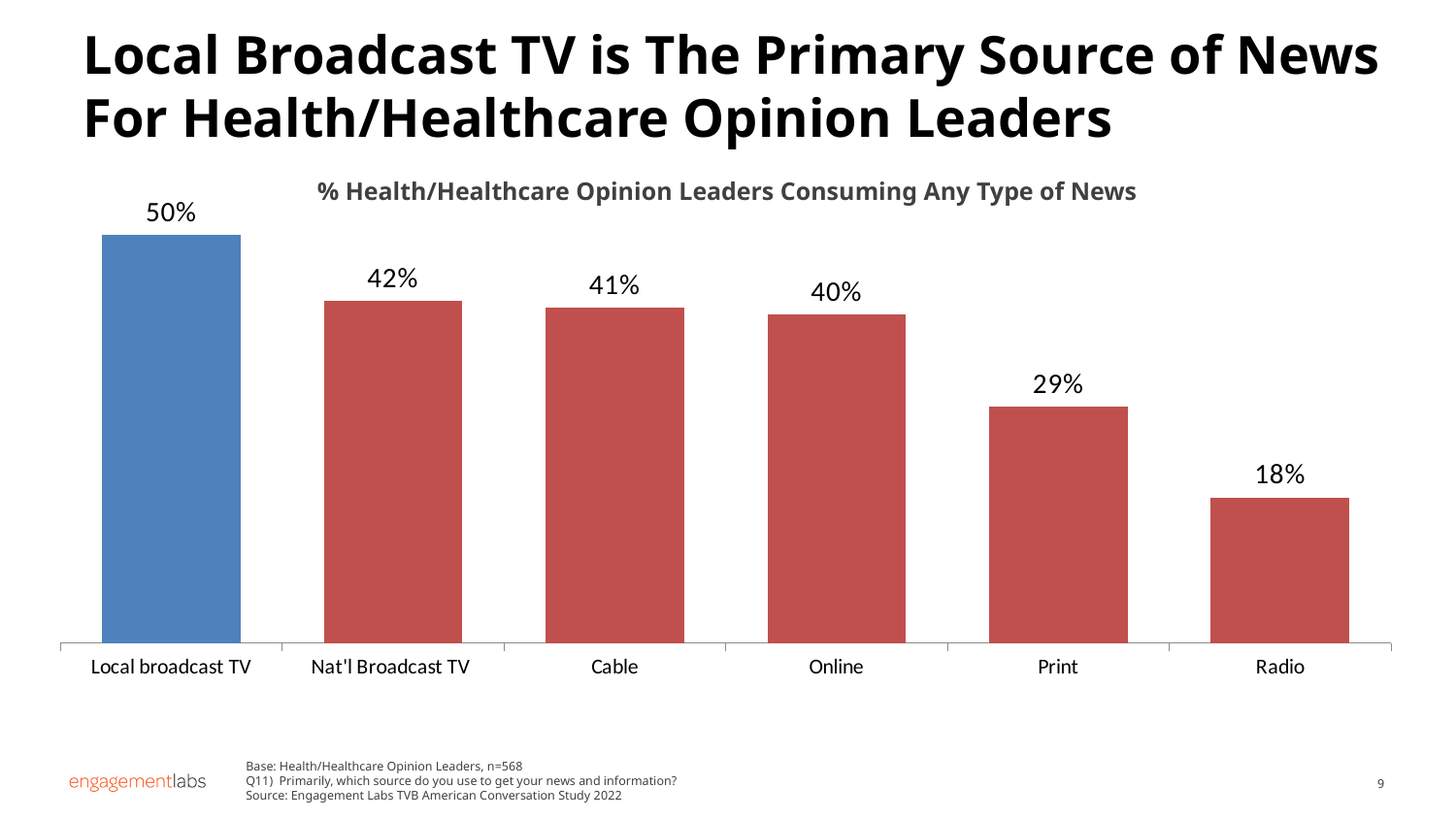
What is the difference between the values for Nat'l Broadcast TV and Print? 13% Which is larger, the value for Cable or the value for Print? Cable What is the difference between the values for Local broadcast TV and Radio? 32% What is the value for Local broadcast TV? 50% What is the value for Online? 40% What is the title of the chart? % Health/Healthcare Opinion Leaders Consuming Any Type of News How many categories are shown in the chart? 6 Which category has the highest value? Local broadcast TV What is the value for Print? 29% What kind of chart is shown on the slide? Bar chart Do the values rise or fall from left to right along the x axis? Fall Which category has the lowest value? Radio